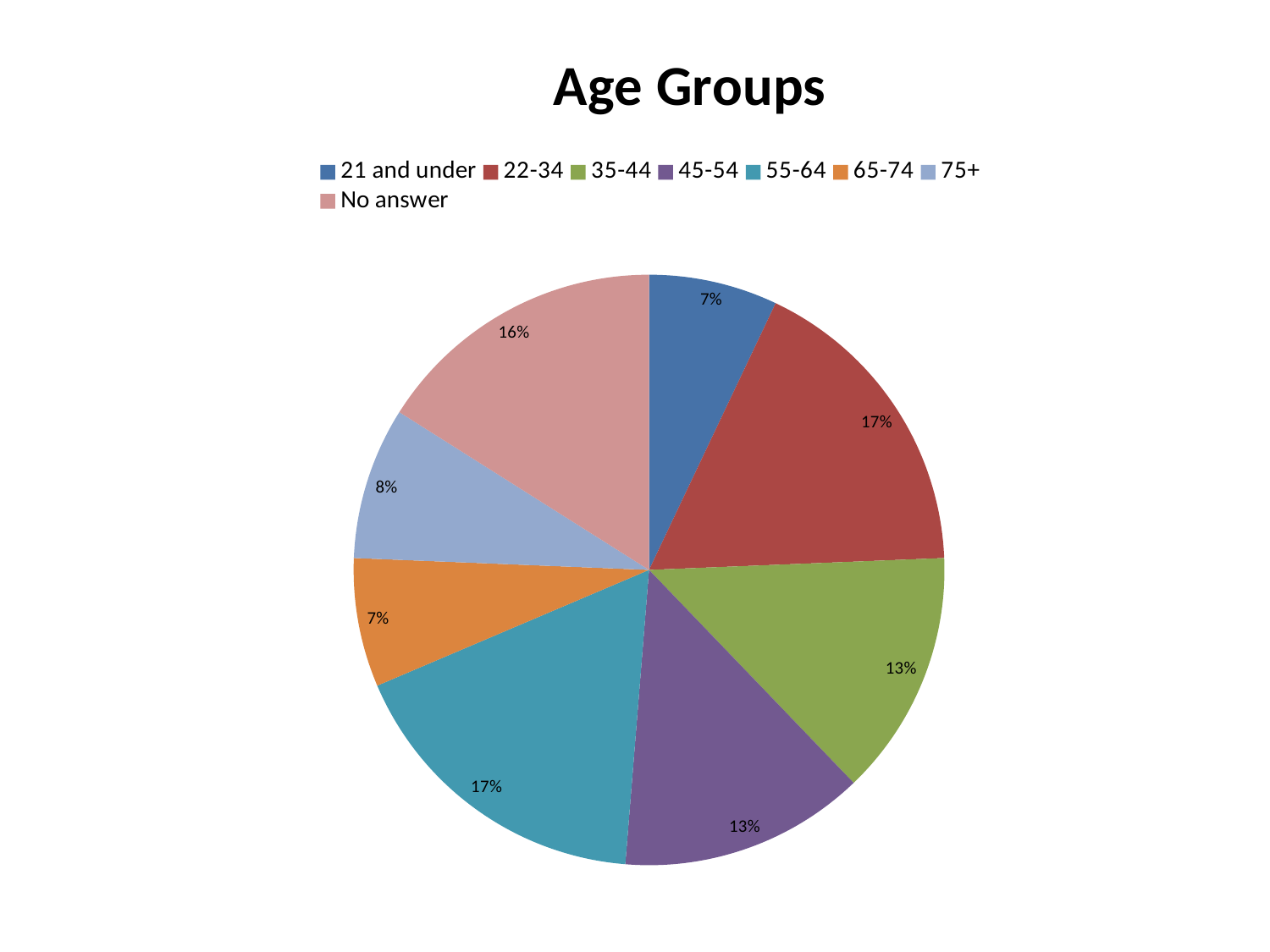
What percentage is shown for the 45-54 age group? 13% What share of the pie does the No answer slice represent? 16% Which is larger, the 22-34 slice or the 35-44 slice? 22-34 What type of chart is shown on the slide? pie chart What percentage of the pie is the 21 and under age group? 7% What is the difference in percentage points between the 55-64 slice and the 65-74 slice? 10 What percentage is shown for the 75+ age group? 8% What is the title of the chart? Age Groups Which legend entry is shown in orange? 65-74 Which is larger, the No answer slice or the 75+ slice? No answer What percentage of the pie is the 22-34 age group? 17% How many age group categories does the pie chart show? 8